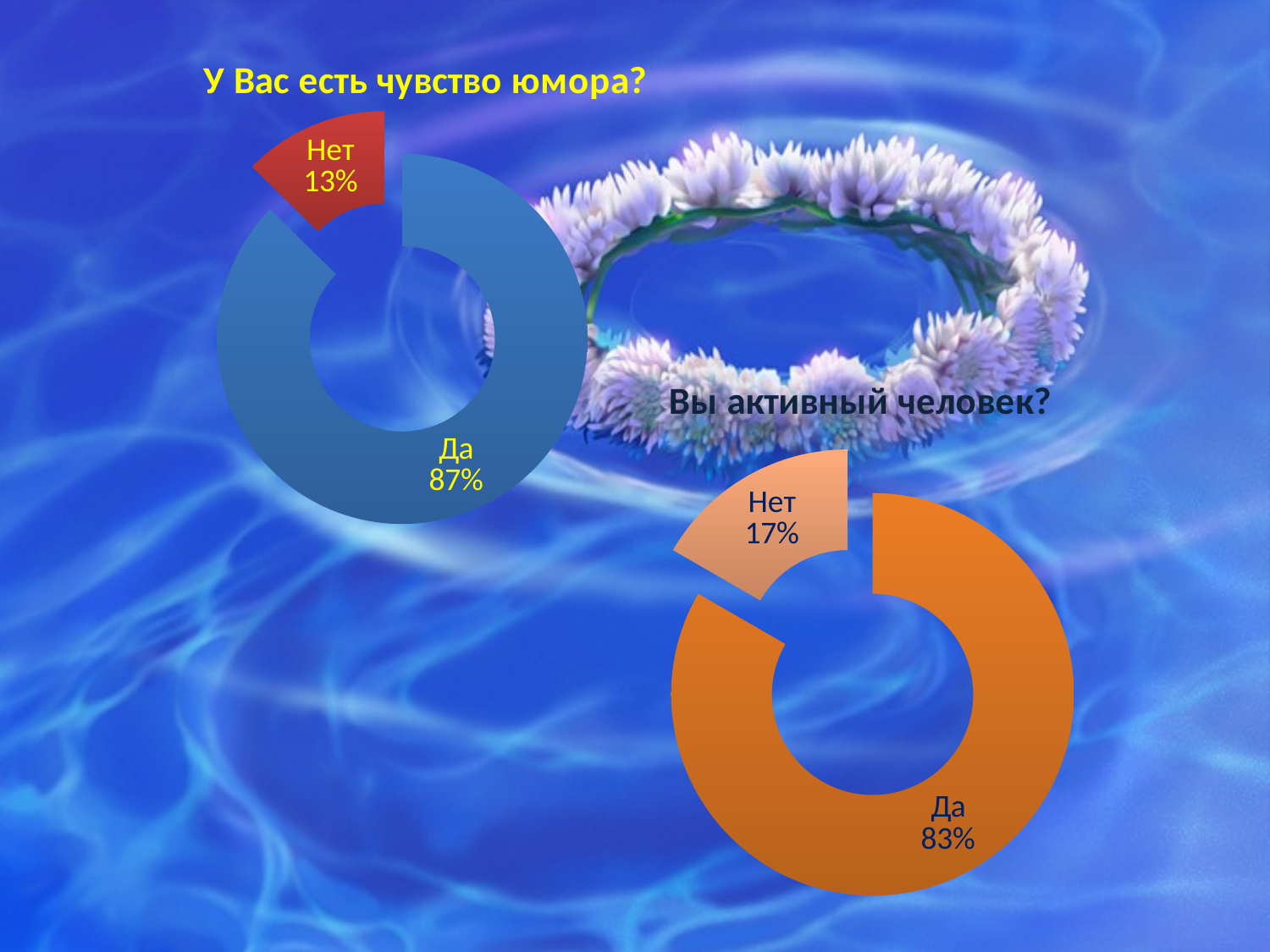
In the chart titled "У Вас есть чувство юмора?", what is the difference between the "Да" and "Нет" shares? 74% In the chart titled "У Вас есть чувство юмора?", what percentage answered "Да"? 87% In the chart titled "У Вас есть чувство юмора?", which answer has the largest share? Да What kind of chart is the chart titled "Вы активный человек?"? Doughnut (pie) chart Which is larger: the "Нет" share in the chart "У Вас есть чувство юмора?" or the "Нет" share in the chart "Вы активный человек?"? Вы активный человек? In the chart titled "Вы активный человек?", what percentage answered "Да"? 83% In the chart titled "У Вас есть чувство юмора?", what percentage answered "Нет"? 13% In the chart titled "Вы активный человек?", which answer has the smallest share? Нет In the chart titled "У Вас есть чувство юмора?", what colour is the "Нет" segment? Red How many categories does the chart titled "У Вас есть чувство юмора?" show? 2 In the chart titled "Вы активный человек?", what percentage answered "Нет"? 17% In the chart titled "Вы активный человек?", what is the difference between the "Да" and "Нет" shares? 66%